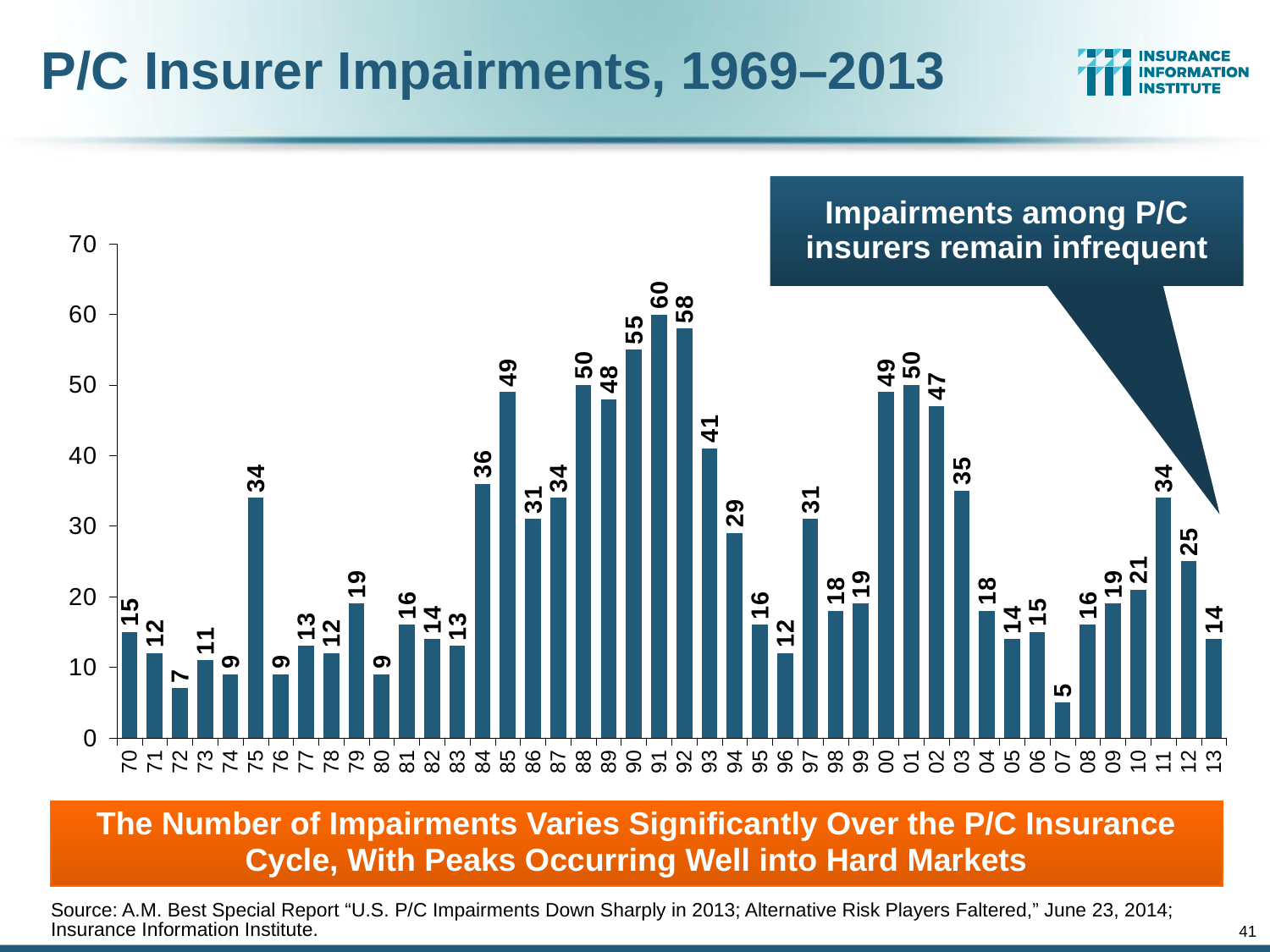
Which year has the lowest number of impairments on the chart? 07 What value is shown for the year labelled '07'? 5 What is the difference between the impairments in '92' and in '93'? 17 How many years (bars) are plotted on the chart? 44 What is the title of the chart on the slide? P/C Insurer Impairments, 1969–2013 Do the values rise or fall from '07' to '11'? Rise What is the number of impairments shown for the year labelled '13'? 14 Which year has more impairments, '85' or '02'? 85 Which year has the highest number of impairments on the chart? 91 What kind of chart is shown on the slide? Bar chart What is the number of P/C insurer impairments shown for 1991 (labelled '91')? 60 Which year has more impairments, '75' or '11'? They are equal (34)